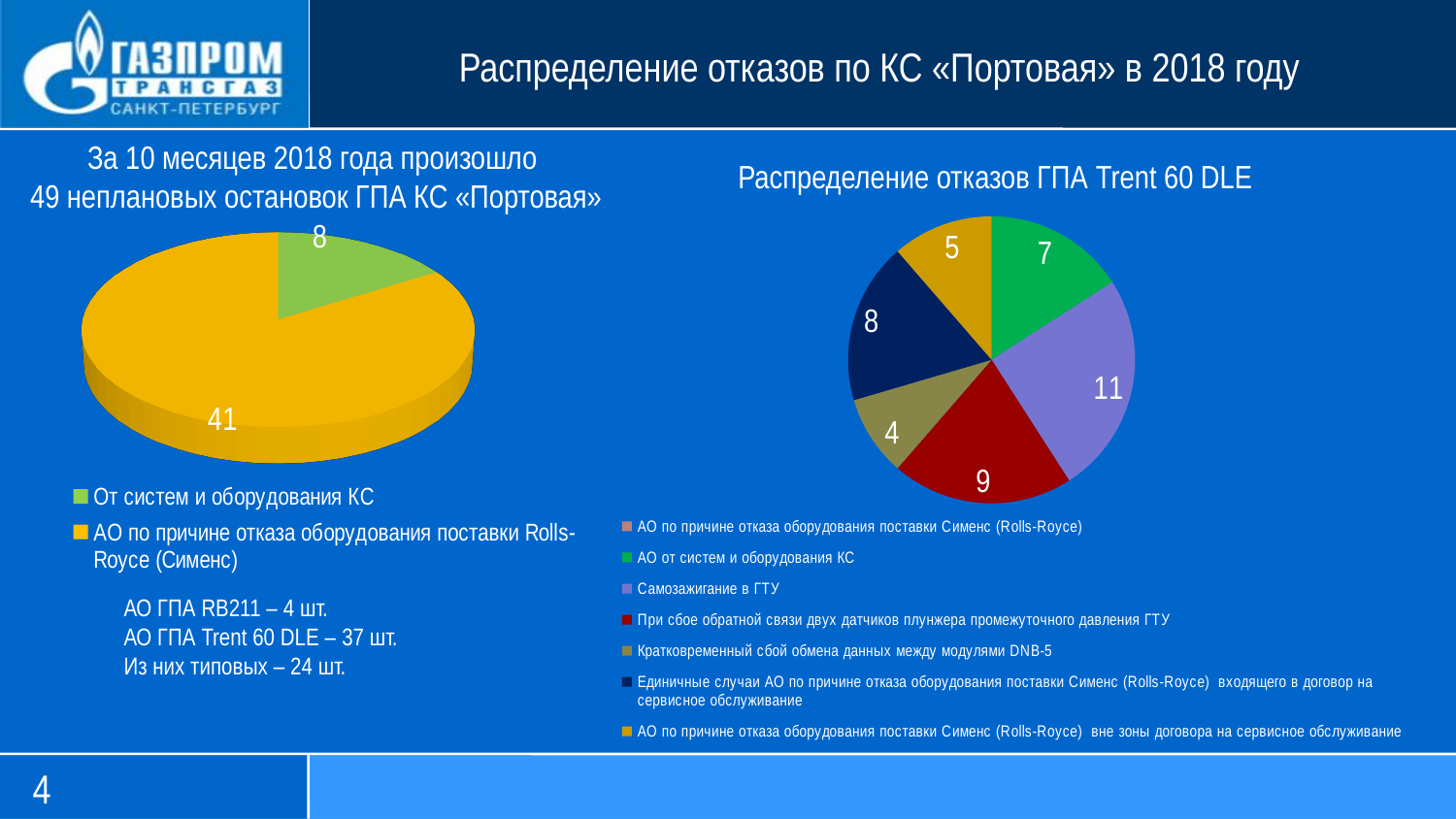
What is the title of the right chart? Распределение отказов ГПА Trent 60 DLE In the left pie chart, what is the difference between the Rolls-Royce (Сименс) slice and the «От систем и оборудования КС» slice? 33 How many slices does the right pie chart «Распределение отказов ГПА Trent 60 DLE» have? 6 How many slices does the left pie chart have? 2 In the right chart «Распределение отказов ГПА Trent 60 DLE», what is the value of the smallest slice? 4 In the right chart «Распределение отказов ГПА Trent 60 DLE», what is the value for «АО от систем и оборудования КС»? 7 In the left pie chart, what is the value for «АО по причине отказа оборудования поставки Rolls-Royce (Сименс)»? 41 What kind of chart is the left chart on the slide? pie chart How many entries does the legend of the right chart «Распределение отказов ГПА Trent 60 DLE» list? 7 In the right chart «Распределение отказов ГПА Trent 60 DLE», what is the value of the largest slice? 11 In the right chart «Распределение отказов ГПА Trent 60 DLE», what is the value for «Самозажигание в ГТУ»? 11 In the left pie chart, what is the value for «От систем и оборудования КС»? 8